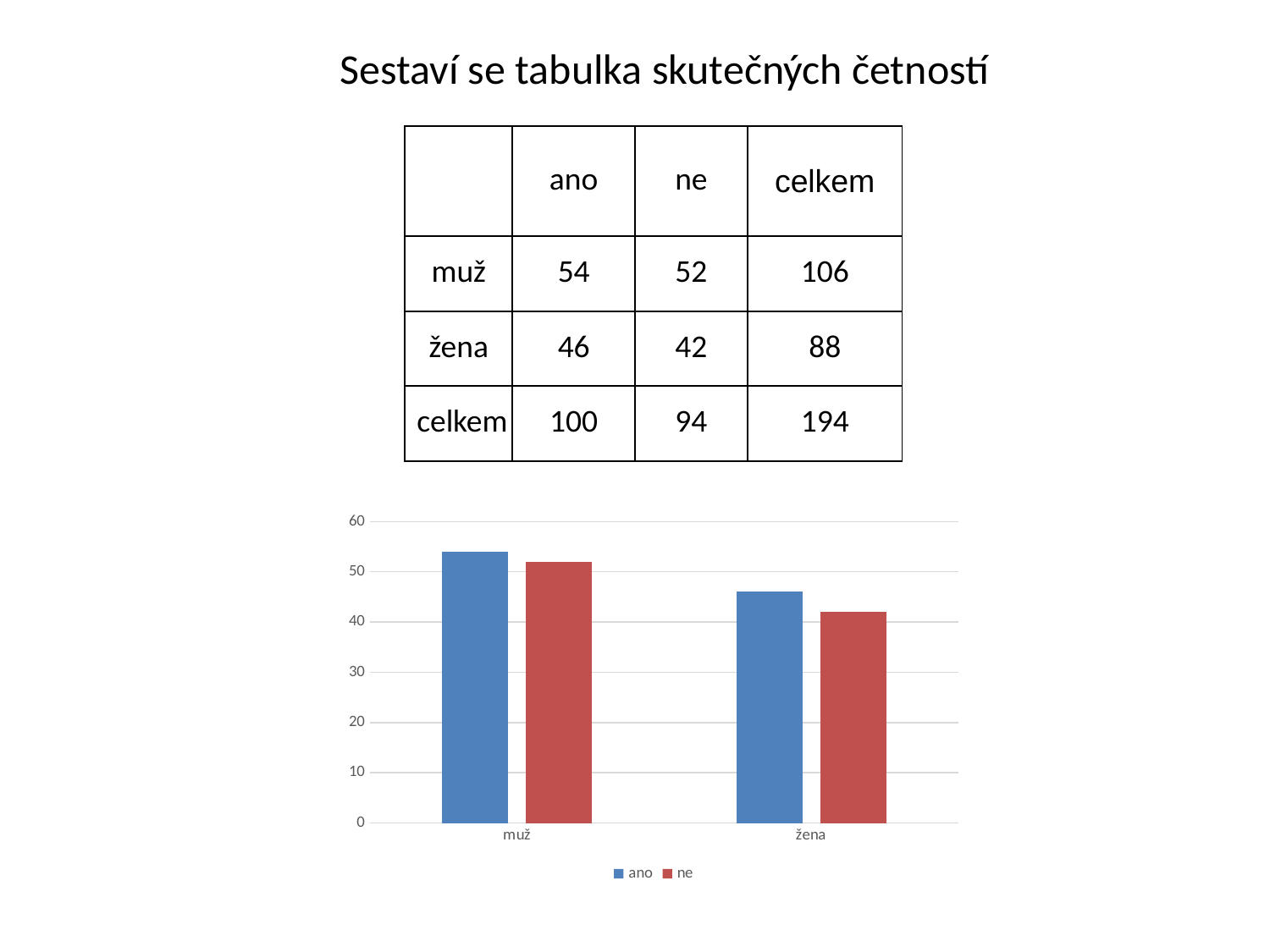
What is the value of the 'ne' bar for 'žena'? 42 What is the value of the 'ano' bar for 'muž'? 54 How many series does the chart legend list? 2 What kind of chart is shown on the slide? bar chart What is the difference between the 'ano' value for 'muž' and the 'ano' value for 'žena'? 8 How many categories are shown on the x axis of the chart? 2 Which category has the higher 'ano' bar, 'muž' or 'žena'? muž What are the two entries in the chart legend? ano, ne For 'žena', which bar is larger, 'ano' or 'ne'? ano Is the 'ano' value for 'muž' greater or less than 50? greater Is the 'ne' value for 'žena' greater or less than 50? less Do the 'ano' values rise or fall from 'muž' to 'žena'? fall